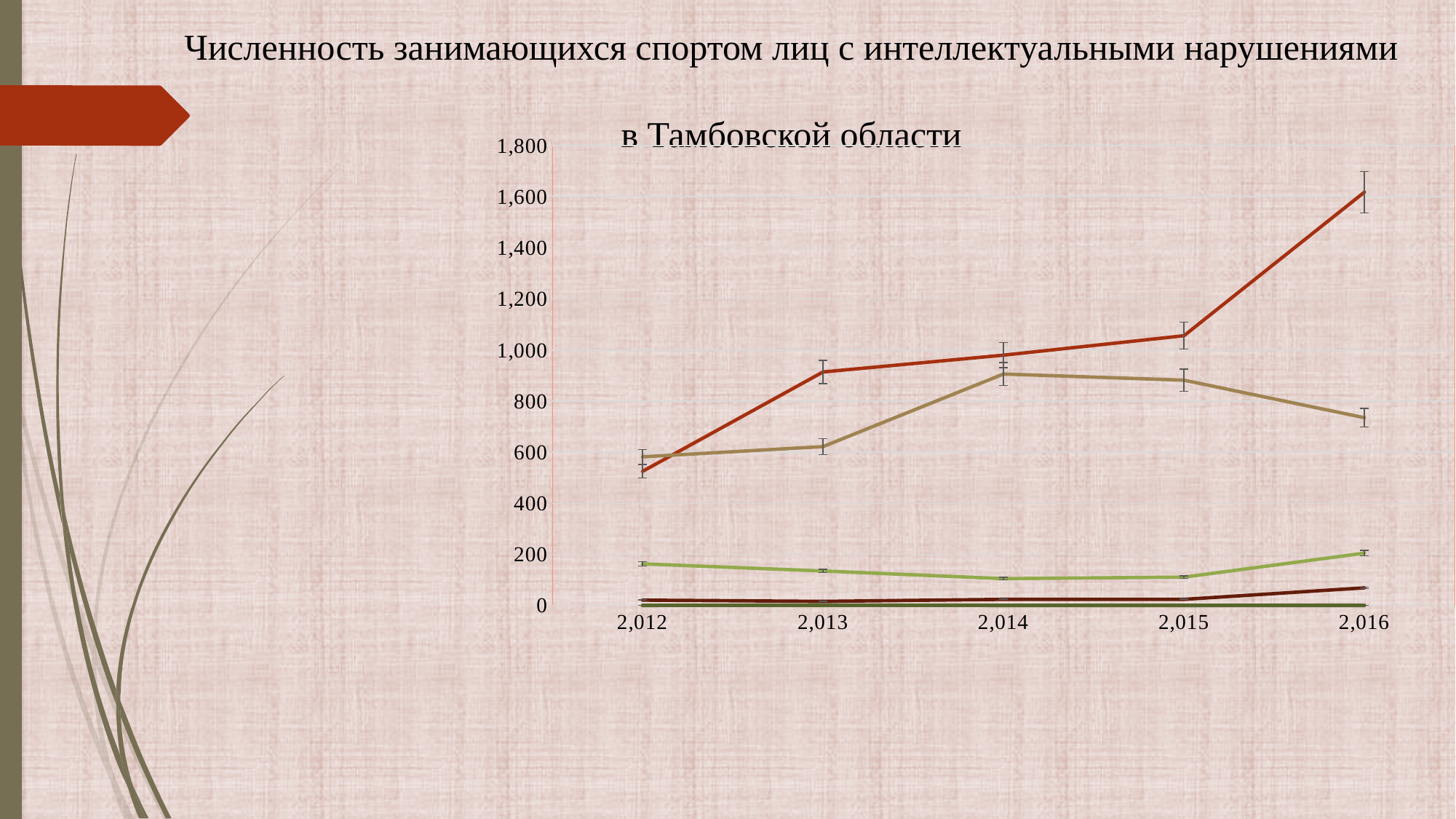
Does the red line rise or fall from 2,012 to 2,016? rise In which year does the red line reach its highest value? 2,016 Which line is higher in 2,016, the red line or the tan (light brown) line? the red line How many years are shown along the x axis of the chart? 5 Is the value of the tan (light brown) line in 2,016 greater or less than 800? less Is the value of the light green line in 2,012 greater or less than 200? less What kind of chart is shown on the slide? line chart Is the value of the red line in 2,012 greater or less than 600? less What is the highest value shown on the y axis of the chart? 1,800 In which year does the tan (light brown) line reach its highest value? 2,014 What is the title of the chart on the slide? Численность занимающихся спортом лиц с интеллектуальными нарушениями в Тамбовской области